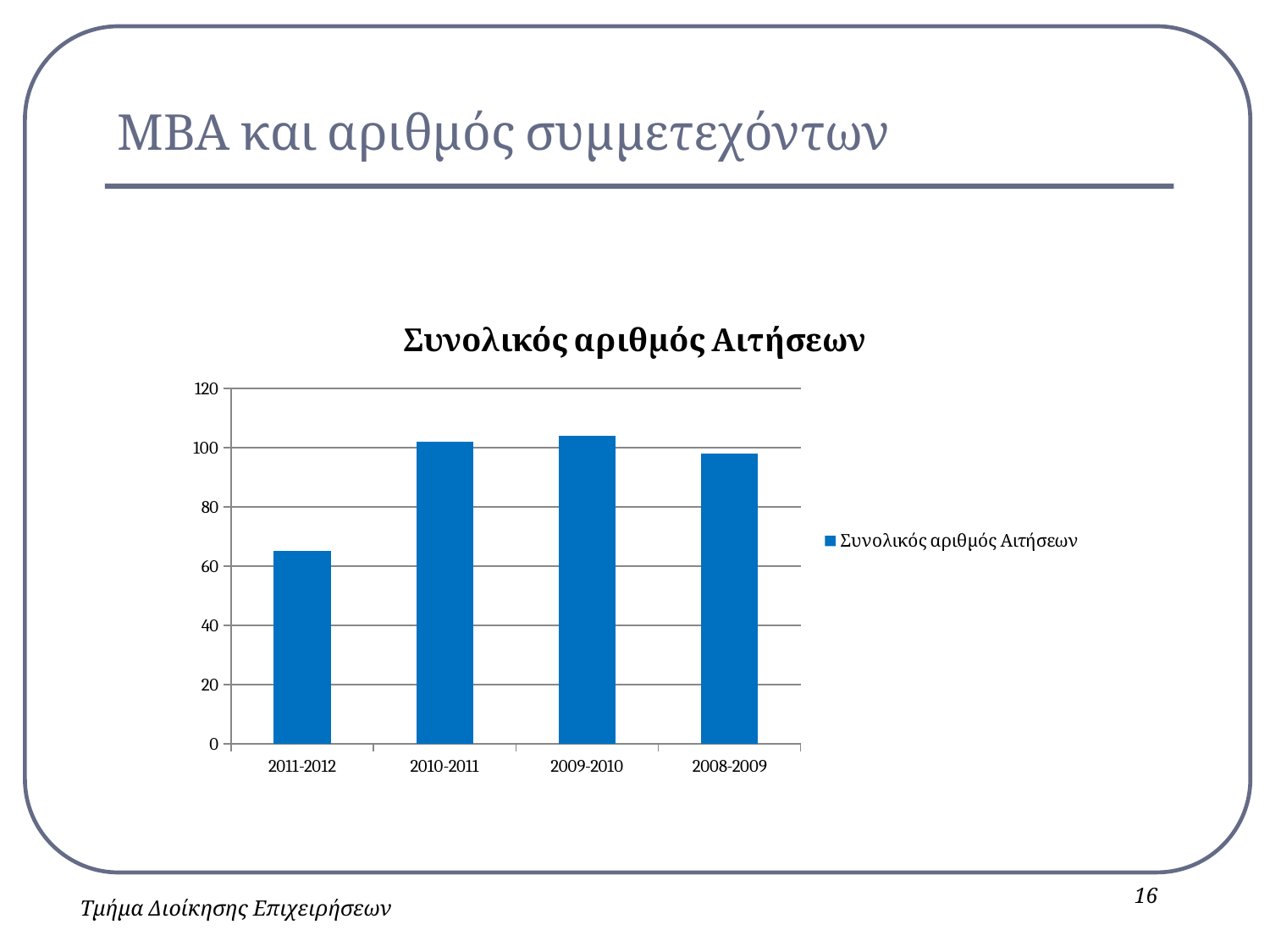
How many series does the legend list? 1 Is the value for 2011-2012 greater or less than 60? greater Is the value for 2008-2009 greater or less than 80? greater How many categories (academic years) are shown on the x axis? 4 Is the value for 2011-2012 greater or less than 80? less What kind of chart is shown on the slide? bar chart What colour are the bars in the chart? blue What is the title of the chart? Συνολικός αριθμός Αιτήσεων Which academic year has the lowest value? 2011-2012 Which is larger, the value for 2011-2012 or the value for 2008-2009? 2008-2009 Which is larger, the value for 2010-2011 or the value for 2011-2012? 2010-2011